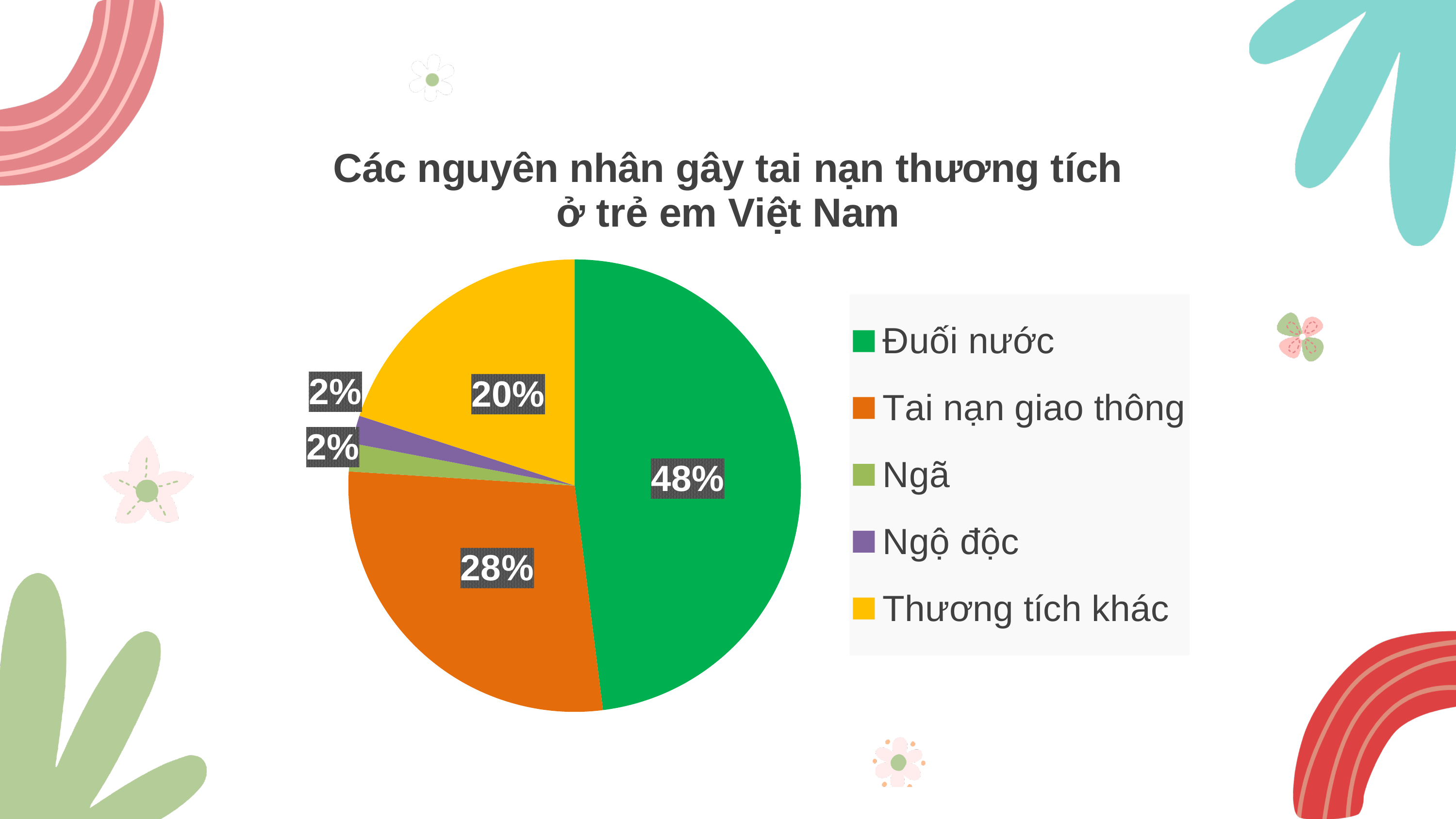
Which colour represents Thương tích khác in the legend? yellow What kind of chart is shown on the slide? pie chart What share of the pie does Thương tích khác account for? 20% What share of the pie does Tai nạn giao thông account for? 28% What share of the pie does Đuối nước account for? 48% Which is larger, the share for Tai nạn giao thông or the share for Thương tích khác? Tai nạn giao thông What is the difference between the shares for Đuối nước and Tai nạn giao thông? 20% What is the title of the chart? Các nguyên nhân gây tai nạn thương tích ở trẻ em Việt Nam What share of the pie does Ngộ độc account for? 2% What share of the pie does Ngã account for? 2% How many categories does the legend list? 5 Which category has the largest share of the pie? Đuối nước